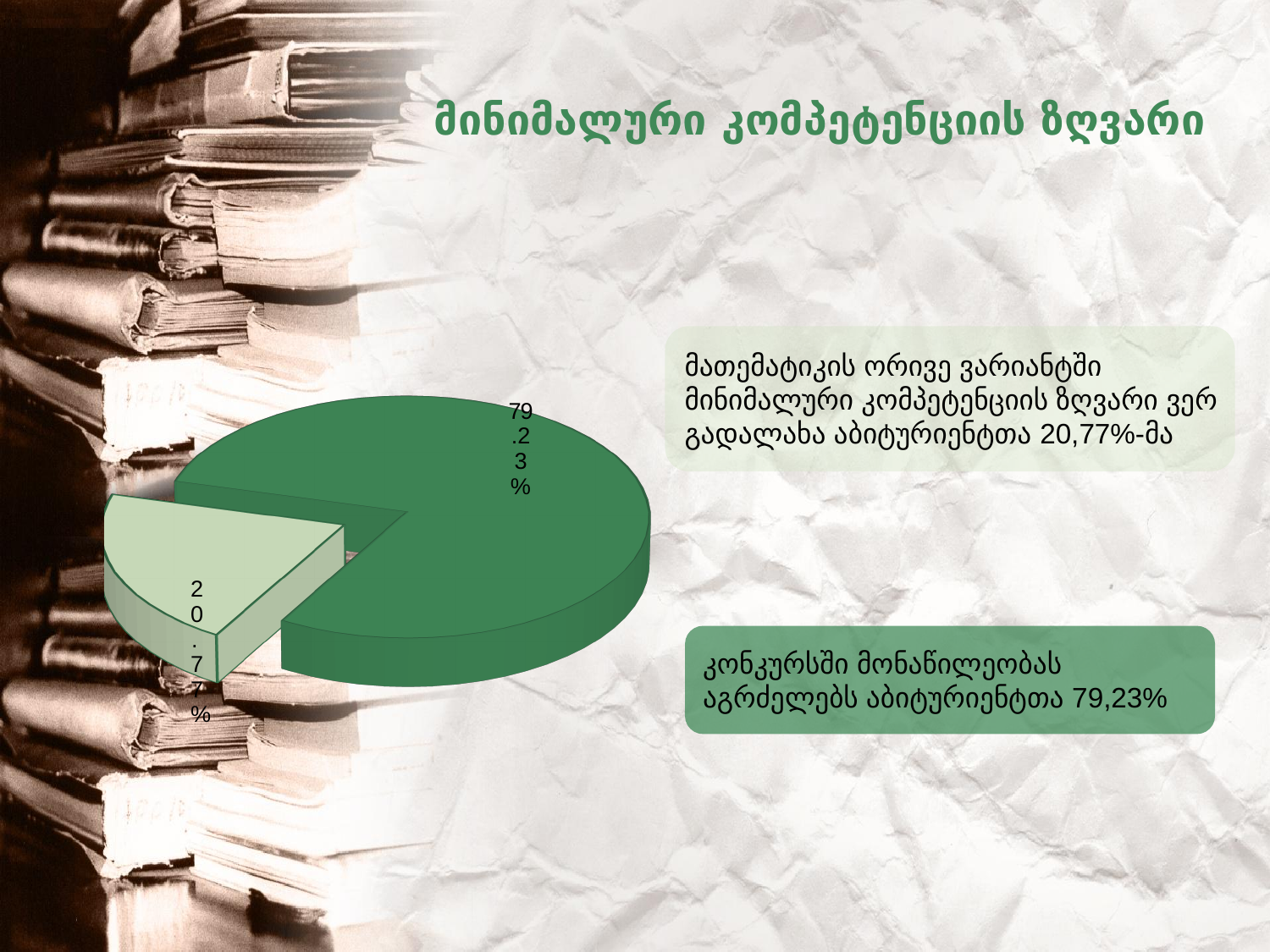
Which slice of the pie chart is the largest? the dark green slice (79.23%) Which slice of the pie chart is the smallest? the light green exploded slice (20.77%) Is the dark green slice larger or smaller than the light green slice? larger How many slices does the pie chart have? 2 What is the difference between the two slice values in the pie chart? 58.46% Is the value of the dark green slice greater or less than 75%? greater What value is labelled on the large dark green slice of the pie chart? 79.23% Which slice of the pie chart is pulled out (exploded) from the rest? the light green slice (20.77%) What value is labelled on the small light green exploded slice of the pie chart? 20.77% Is the value of the light green slice greater or less than 25%? less What kind of chart is shown on the slide? pie chart Does the pie chart have a legend? no